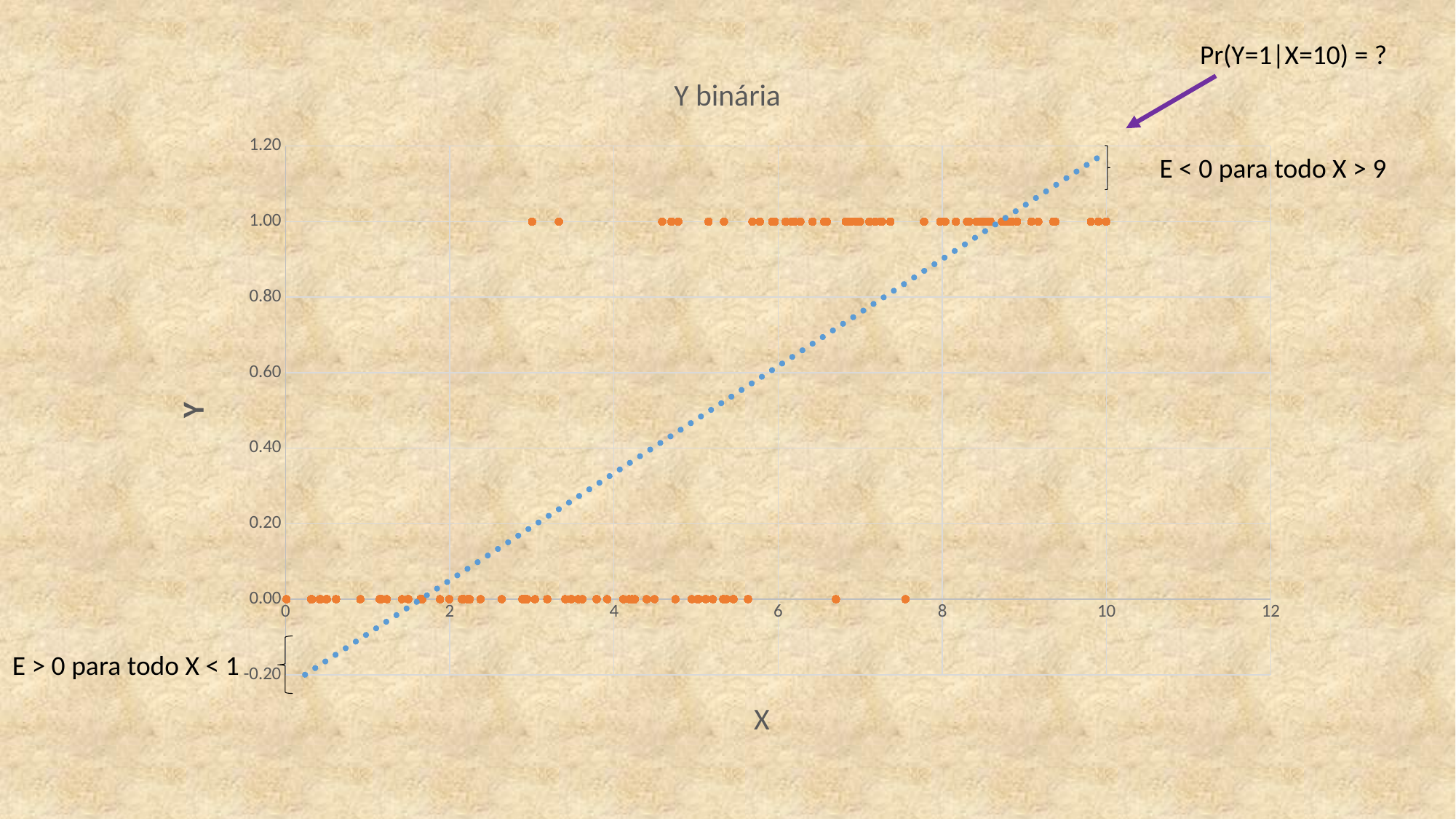
What is the label of the horizontal axis of the chart? X What is the title of the chart? Y binária What is the lowest tick value shown on the Y axis? -0.20 Does the dotted trend line rise or fall as X increases? rises Is the value of the dotted trend line at X=10 greater or less than 1.00? greater Is the value of the dotted trend line at X=2 greater or less than 0.20? less Is the value of the dotted trend line at X=6 greater or less than 0.40? greater What kind of chart is shown on the slide? scatter chart What is the highest tick value shown on the X axis? 12 What are the two Y values at which the orange data points lie? 0.00 and 1.00